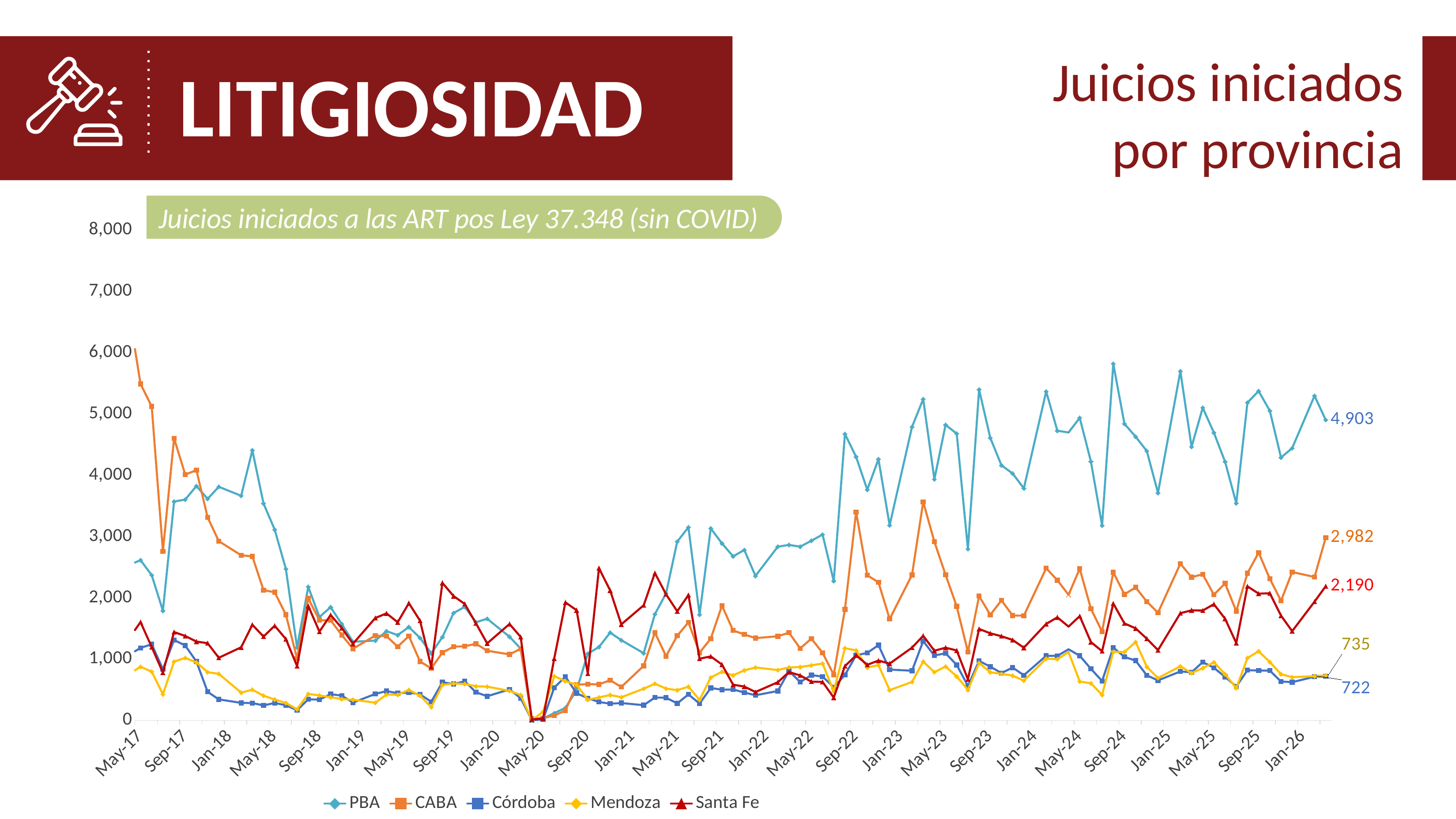
How many series does the legend list? 5 What is the last labelled value for the Mendoza series? 735 What is the last labelled value for the Santa Fe series? 2,190 What is the difference between the final labelled values of PBA and CABA? 1,921 Which series has the lowest final labelled value? Córdoba What is the last labelled value for the CABA series? 2,982 What is the last labelled value for the Córdoba series? 722 What is the difference between the final labelled values of CABA and Santa Fe? 792 Which series has the highest final labelled value? PBA What kind of chart is shown on the slide? Line chart What is the last labelled value for the PBA series? 4,903 Is the value for CABA at May-17 greater or less than 5,000? greater